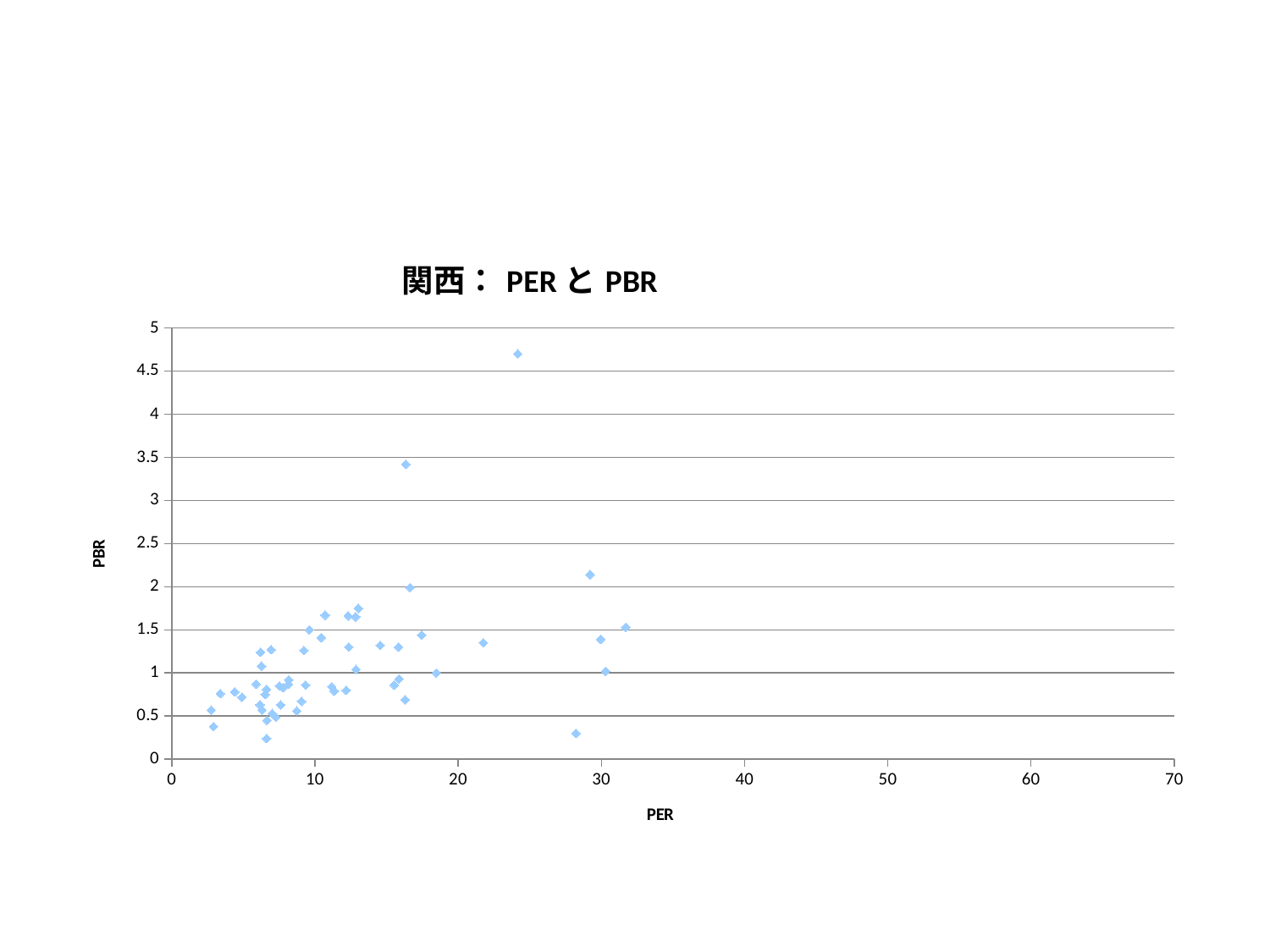
Are there any points plotted with a PER greater than 50? No What is the label of the horizontal axis? PER Is the PER of the point with the highest PBR greater or less than 30? less Is the PER of the point with the highest PBR greater or less than 20? greater What kind of chart is shown on the slide? Scatter chart What is the title of the chart? 関西： PER と PBR